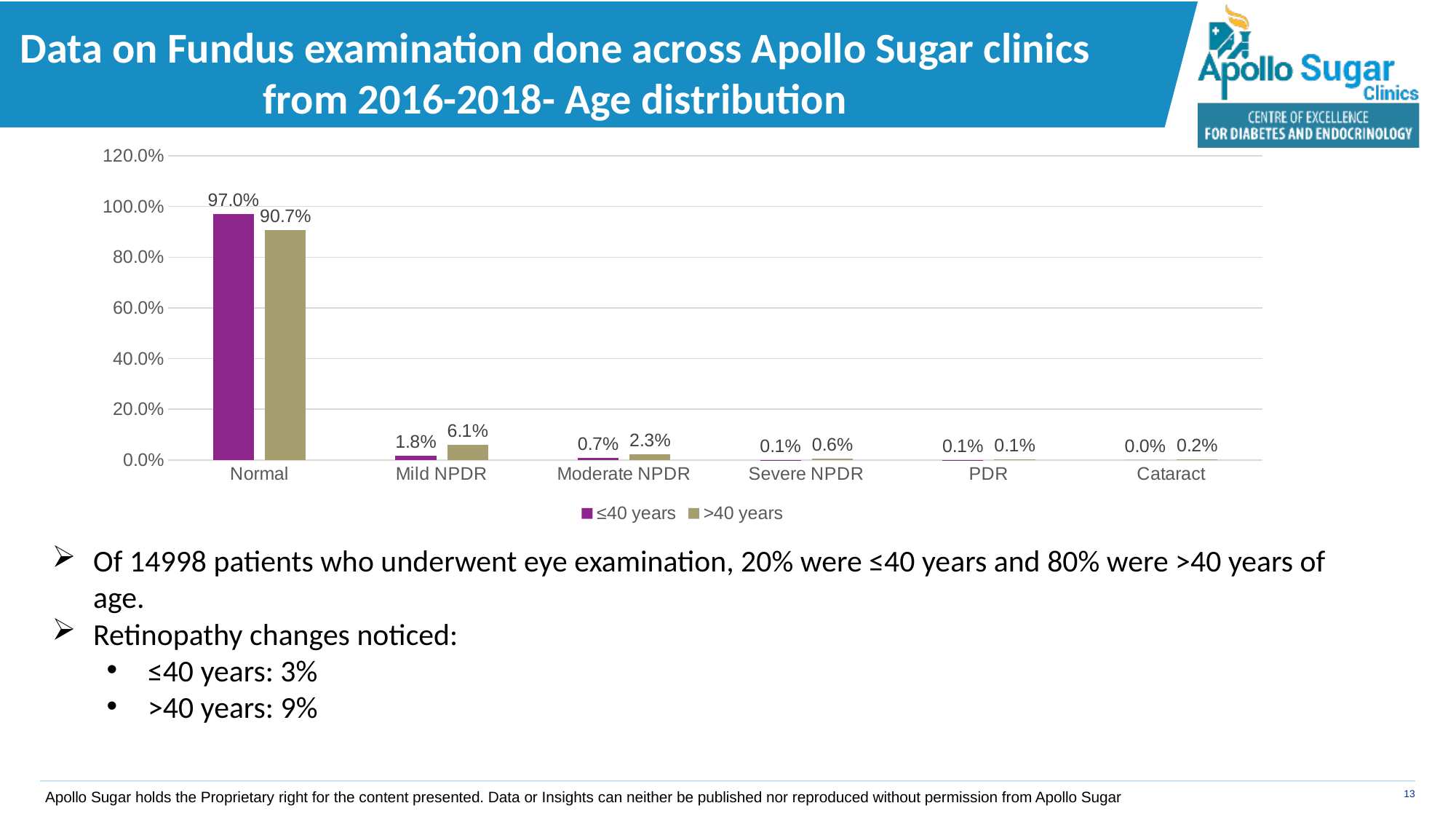
What is the difference between the ≤40 years and >40 years values for Normal? 6.3% How many categories are shown on the x axis? 6 What kind of chart is shown on the slide? Bar chart How many series does the legend list? 2 Which category has the lowest value in the ≤40 years series? Cataract What is the value for Normal in the >40 years series? 90.7% Which category has the highest value in the >40 years series? Normal For Mild NPDR, which series has the larger value, ≤40 years or >40 years? >40 years What is the value for Moderate NPDR in the ≤40 years series? 0.7% What is the value for Normal in the ≤40 years series? 97.0% What is the value for Cataract in the >40 years series? 0.2% What is the value for Mild NPDR in the >40 years series? 6.1%